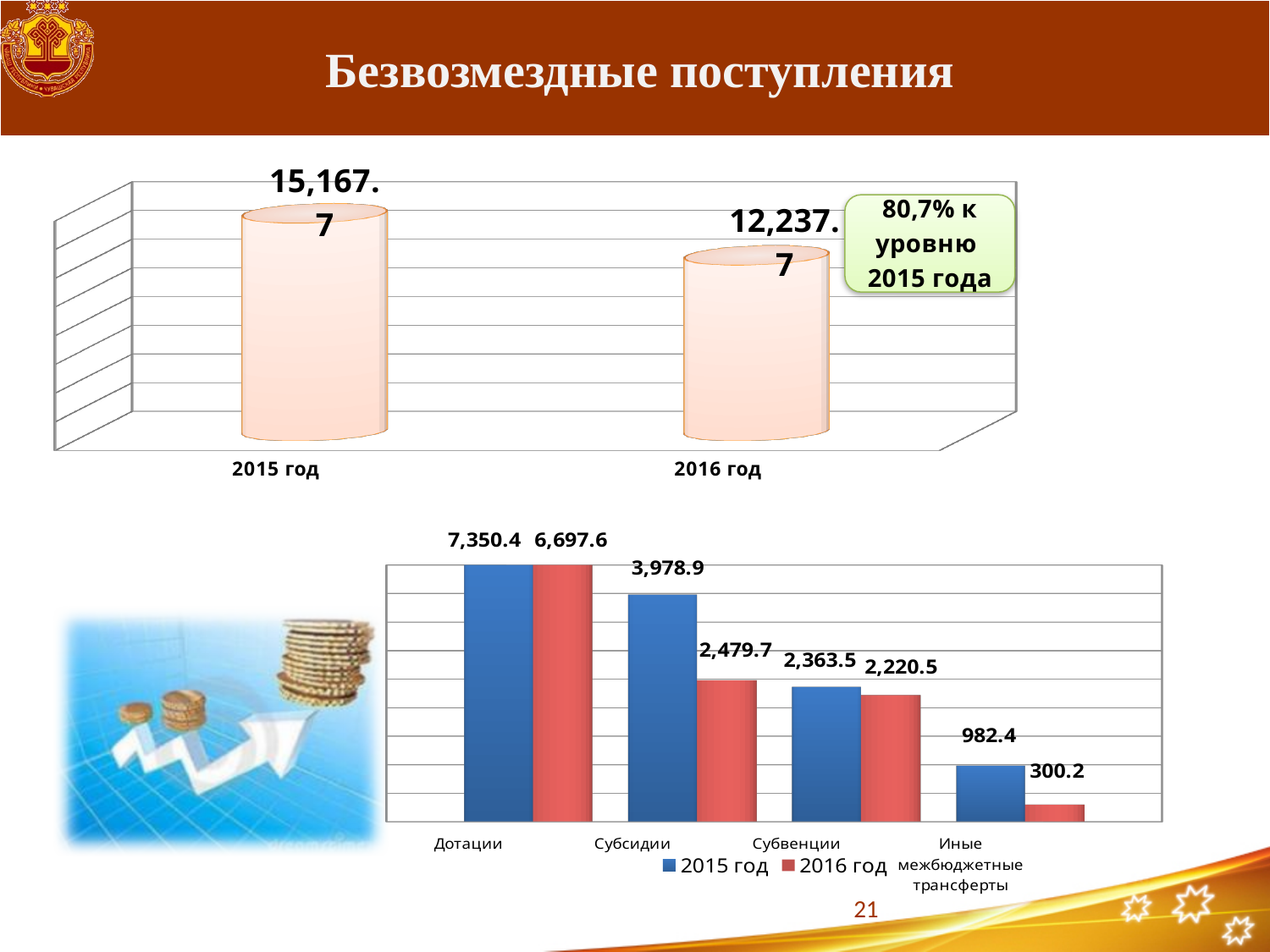
In the bottom chart, what is the value for Субсидии in 2016 год? 2,479.7 In the top chart, which year has the higher value, 2015 год or 2016 год? 2015 год In the bottom chart, what is the value for Иные межбюджетные трансферты in 2016 год? 300.2 In the bottom chart, what is the value for Дотации in 2015 год? 7,350.4 In the top chart, what is the difference between the 2015 год and 2016 год values? 2,930.0 In the top chart, what is the value for 2015 год? 15,167.7 How many series does the legend of the bottom chart list? 2 In the top chart, what is the value for 2016 год? 12,237.7 In the bottom chart, which category has the lowest value for 2016 год? Иные межбюджетные трансферты In the bottom chart, which category has the highest value for 2015 год? Дотации In the bottom chart, what is the difference between the 2015 год and 2016 год values for Субсидии? 1,499.2 How many categories are shown on the x axis of the bottom chart? 4